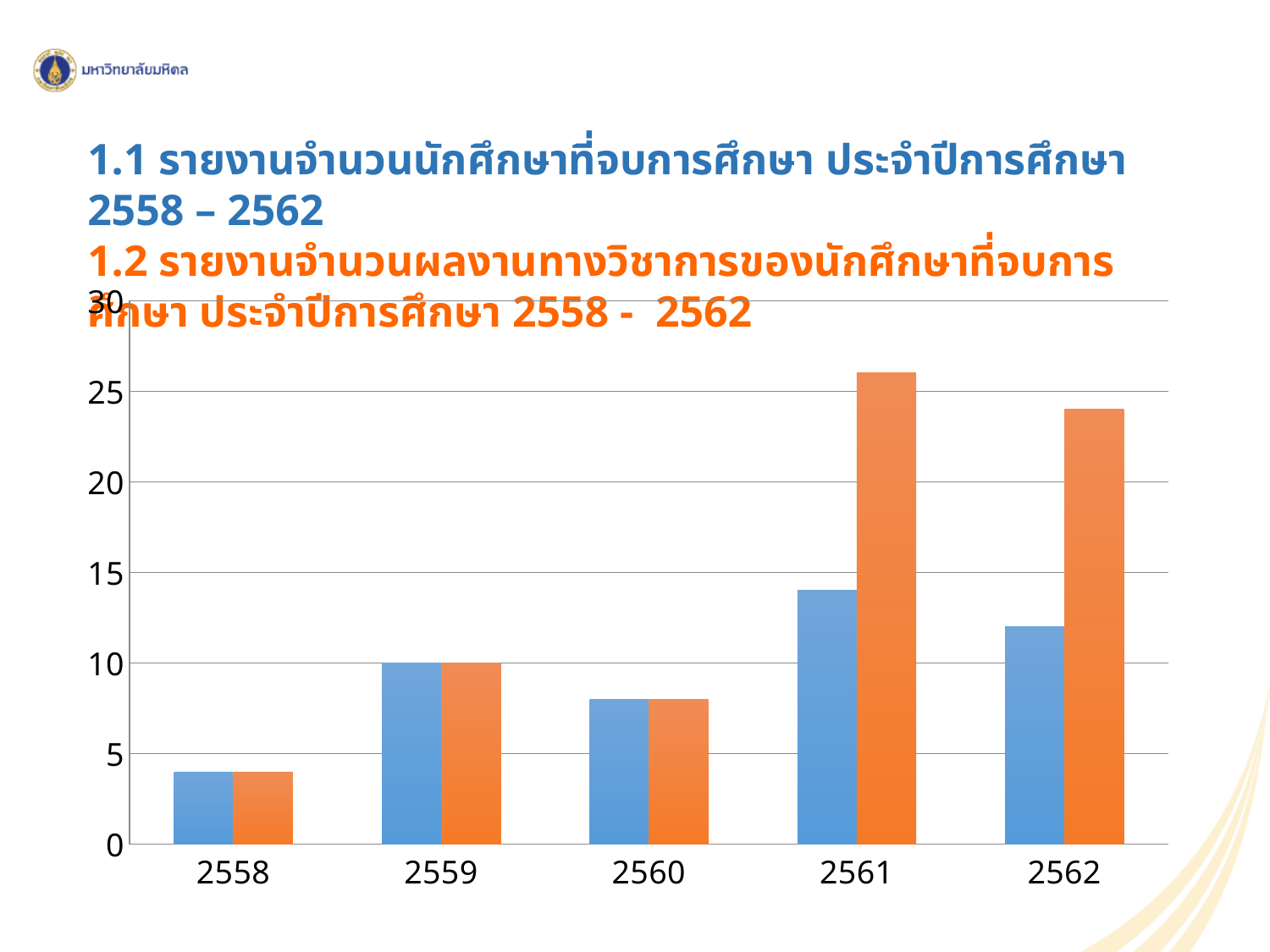
How many year categories are shown on the x axis of the chart? 5 Is the value of the orange bar for 2561 greater or less than 25? greater Is the value of the blue bar for 2561 greater or less than 15? less What kind of chart is shown on the slide? bar chart For 2562, which bar is larger, the blue bar or the orange bar? the orange bar What is the value of the orange bar for 2559? 10 What is the value of the blue bar for 2559? 10 Is the value of the blue bar for 2558 greater or less than 5? less In which year is the orange bar the highest? 2561 In which year is the blue bar the highest? 2561 How many bars are shown for each year category? 2 In which year is the blue bar the lowest? 2558